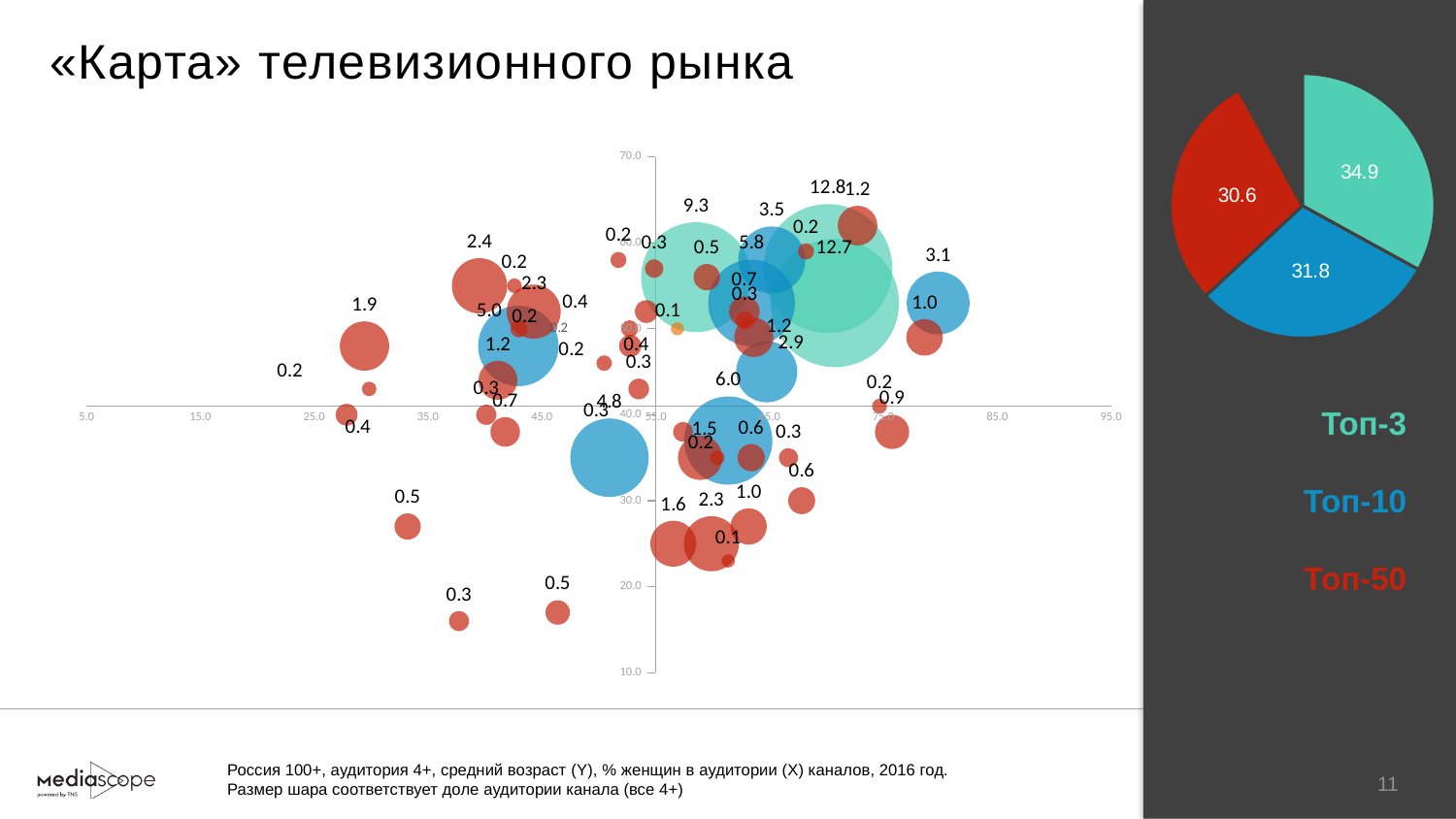
What kind of chart is the chart on the right side of the slide? Pie chart On the pie chart on the right, what is the difference between the Топ-3 value and the Топ-10 value? 3.1 On the pie chart on the right, what value is shown for the Топ-10 slice? 31.8 On the bubble chart on the left, what is the largest data label shown on any bubble? 12.8 On the pie chart on the right, what value is shown for the Топ-50 slice? 30.6 On the pie chart on the right, what value is shown for the Топ-3 slice? 34.9 What kind of chart is the large chart on the left side of the slide? Bubble chart On the pie chart on the right, what is the difference between the Топ-3 value and the Топ-50 value? 4.3 On the pie chart on the right, which slice has the largest value? Топ-3 On the pie chart on the right, which is larger: the Топ-10 value or the Топ-50 value? Топ-10